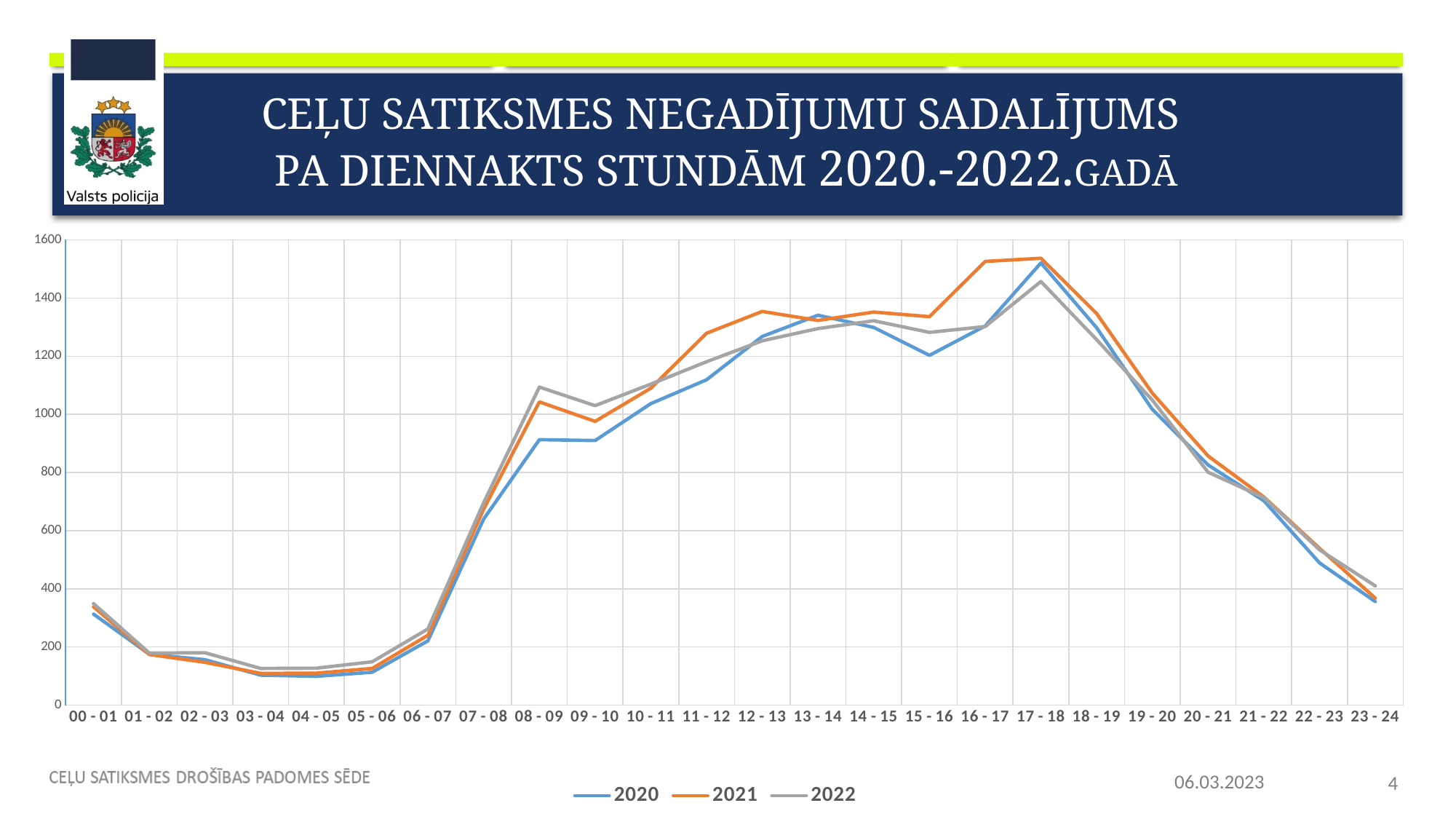
Which hourly interval has the highest value for the 2022 series? 17 - 18 Do the values for the 2021 series rise or fall from 17 - 18 to 23 - 24? fall At 08 - 09, which series has the larger value, 2020 or 2022? 2022 How many series does the legend list? 3 How many hourly intervals are shown along the x axis? 24 What kind of chart is shown on the slide? line chart Is the value for 2021 at 03 - 04 greater or less than 200? less Which series has the lowest value at 08 - 09? 2020 At 15 - 16, which series has the larger value, 2020 or 2021? 2021 Is the value for 2020 at 17 - 18 greater or less than 1400? greater Which hourly interval has the highest value for the 2020 series? 17 - 18 Which colour is used for the 2021 series in the legend? orange